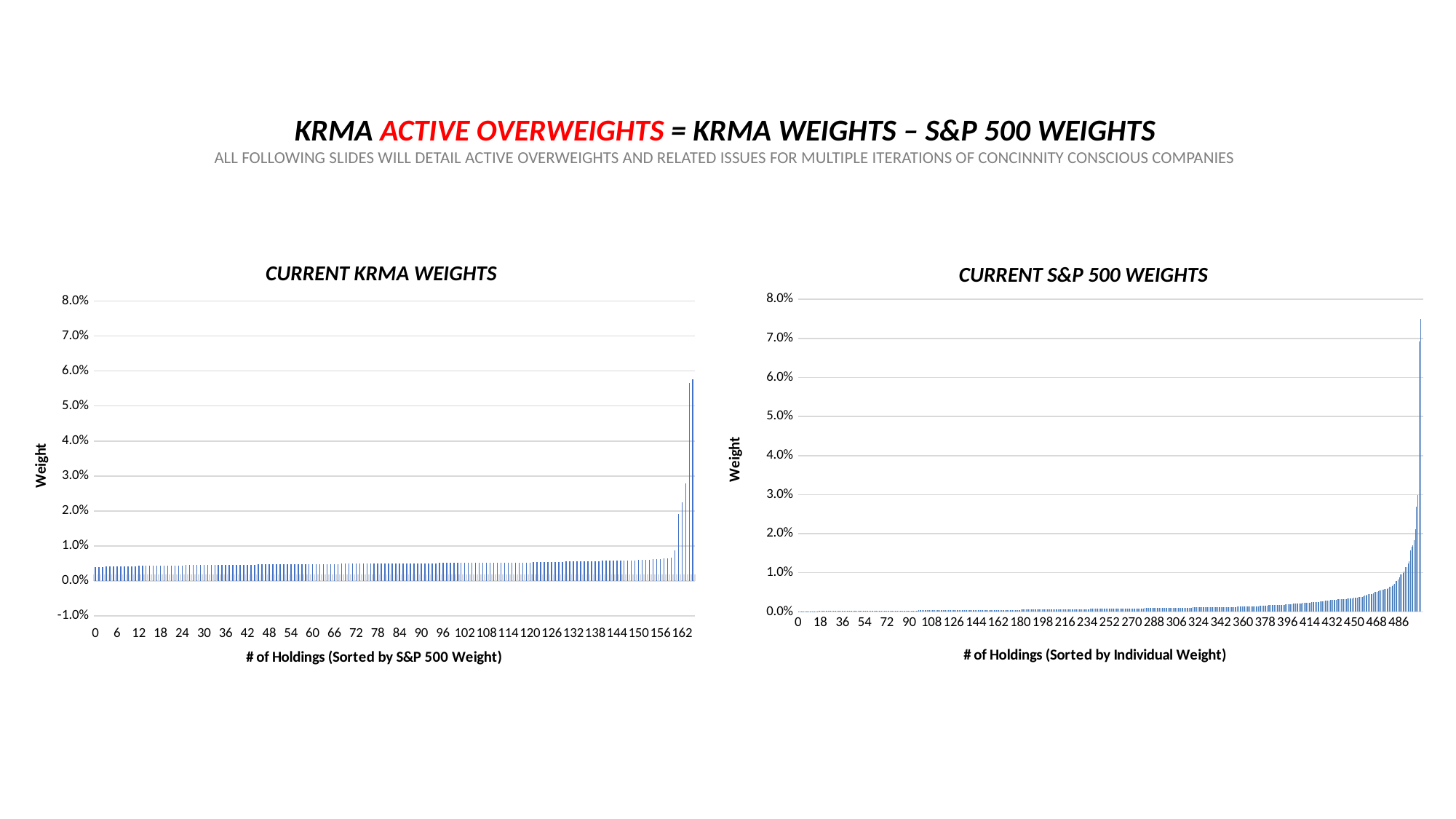
In the "CURRENT KRMA WEIGHTS" chart, do the bar values rise or fall moving left to right along the x axis? Rise What is the x-axis title of the "CURRENT S&P 500 WEIGHTS" chart? # of Holdings (Sorted by Individual Weight) In the "CURRENT S&P 500 WEIGHTS" chart, is the value of the tallest bar greater or less than 8.0%? less Which chart has the taller maximum bar, "CURRENT KRMA WEIGHTS" or "CURRENT S&P 500 WEIGHTS"? CURRENT S&P 500 WEIGHTS What kind of chart is the "CURRENT S&P 500 WEIGHTS" chart on the right? Bar chart What kind of chart is the "CURRENT KRMA WEIGHTS" chart on the left? Bar chart In the "CURRENT S&P 500 WEIGHTS" chart, do the bar values rise or fall moving left to right along the x axis? Rise In the "CURRENT S&P 500 WEIGHTS" chart, is the value of the tallest bar greater or less than 7.0%? greater In the "CURRENT KRMA WEIGHTS" chart, is the value of the tallest bar greater or less than 6.0%? less In the "CURRENT KRMA WEIGHTS" chart, what is the lowest value shown on the y axis? -1.0%